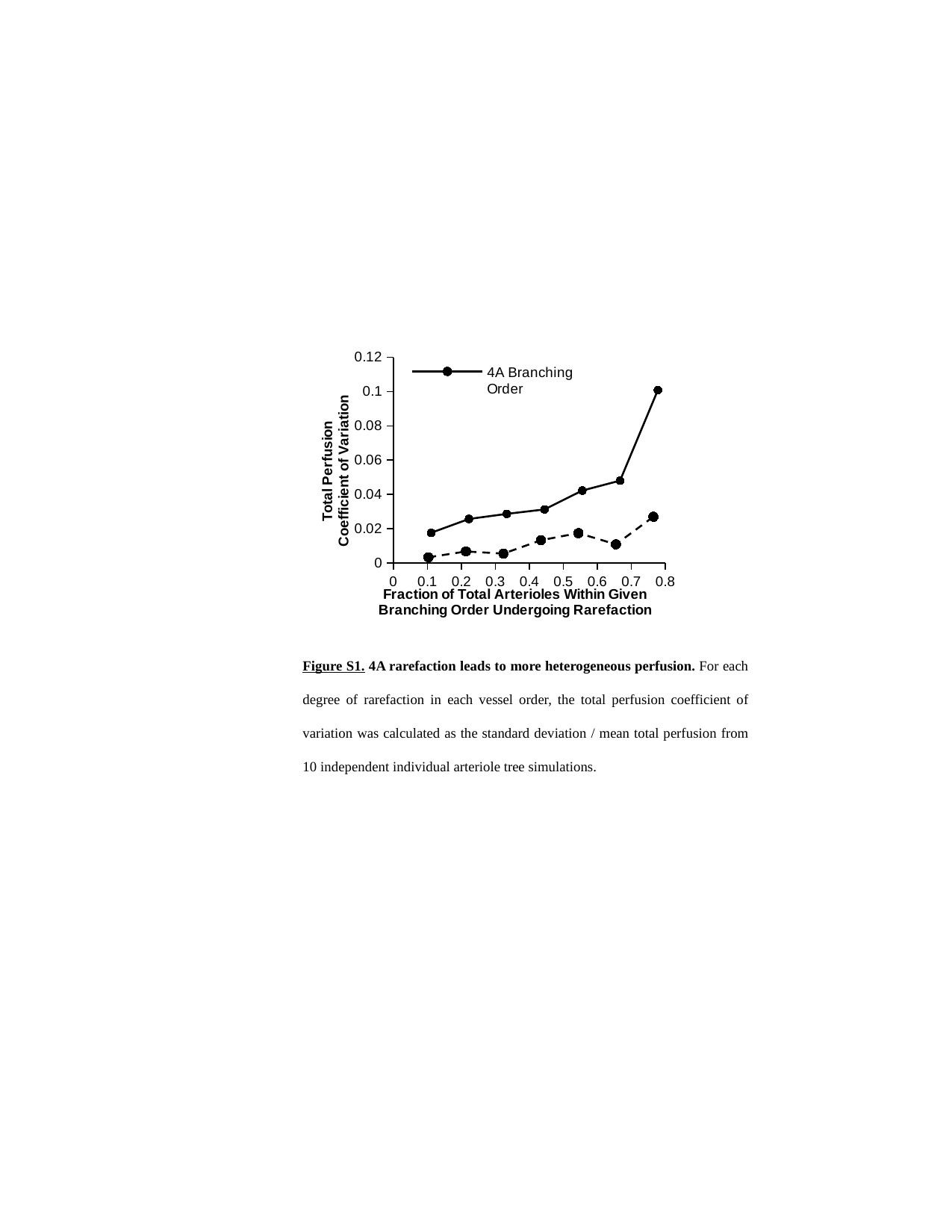
How many data points are plotted on the solid 4A Branching Order line? 7 What is the name of the series listed in the legend? 4A Branching Order At which x-axis position does the solid 4A Branching Order line reach its highest value? the rightmost point, near 0.8 Is the value of the solid 4A Branching Order line at its first point (near 0.1) greater or less than 0.04? less Is the value of the solid 4A Branching Order line at its last point (near 0.8) greater or less than 0.06? greater Is the value of the dashed line at its last point (near 0.8) greater or less than 0.04? less At the rightmost data point (near 0.8), which line has the larger value, the solid 4A Branching Order line or the dashed line? the solid 4A Branching Order line What is the label of the y axis? Total Perfusion Coefficient of Variation Do the values of the solid 4A Branching Order line generally rise or fall as the fraction of arterioles undergoing rarefaction increases? rise What kind of chart is shown on the slide? line chart How many series does the chart's legend list? 1